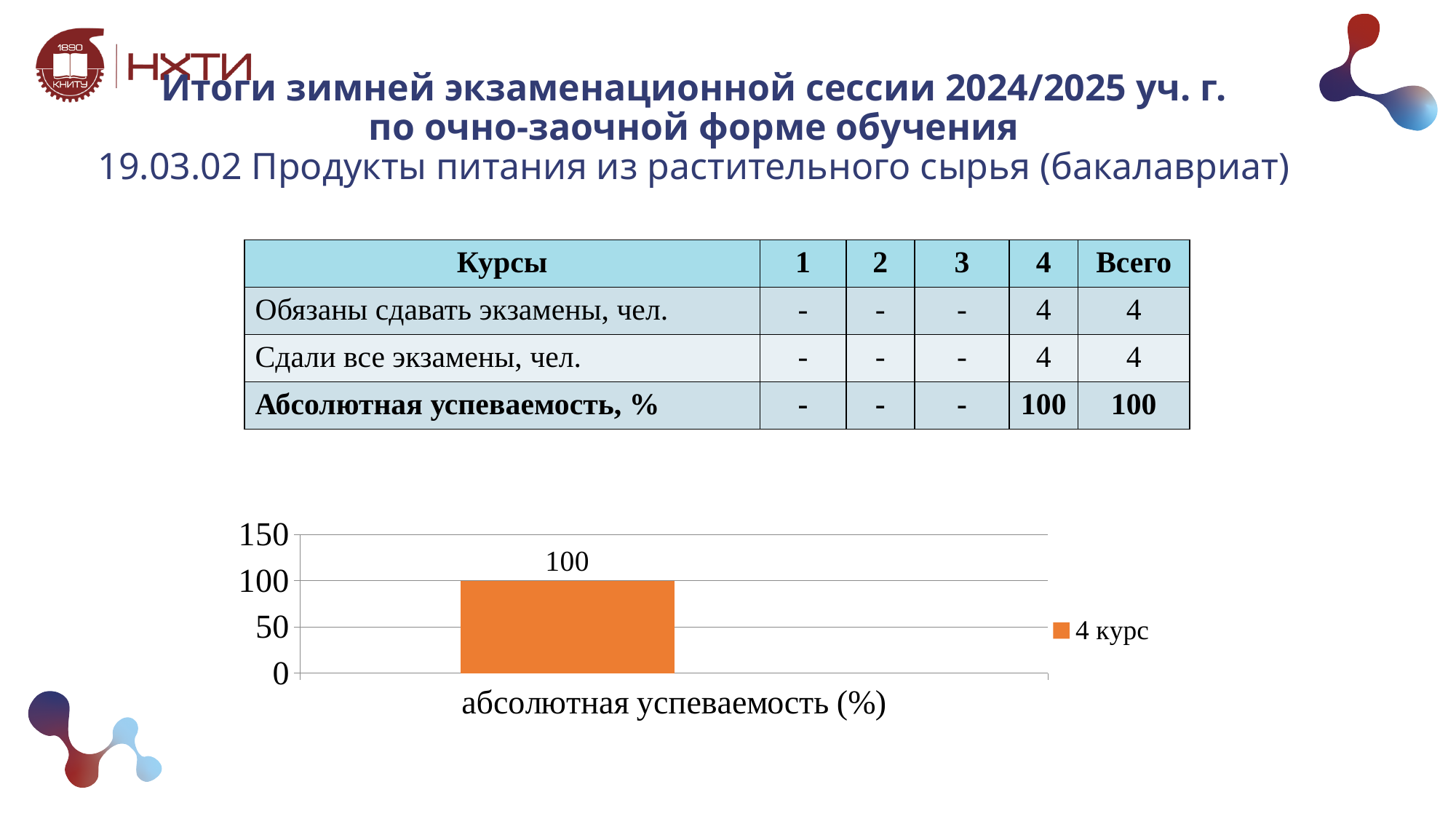
What is the value of the bar for 4 курс in the chart? 100 What series name appears in the chart legend? 4 курс Is the value for 4 курс greater or less than 150? less How many series does the chart legend list? 1 What is the highest tick value shown on the vertical axis of the chart? 150 Is the value for 4 курс greater or less than 50? greater What kind of chart is shown on the slide? bar chart What is the category label shown on the x axis of the chart? абсолютная успеваемость (%) How many bars are plotted in the chart? 1